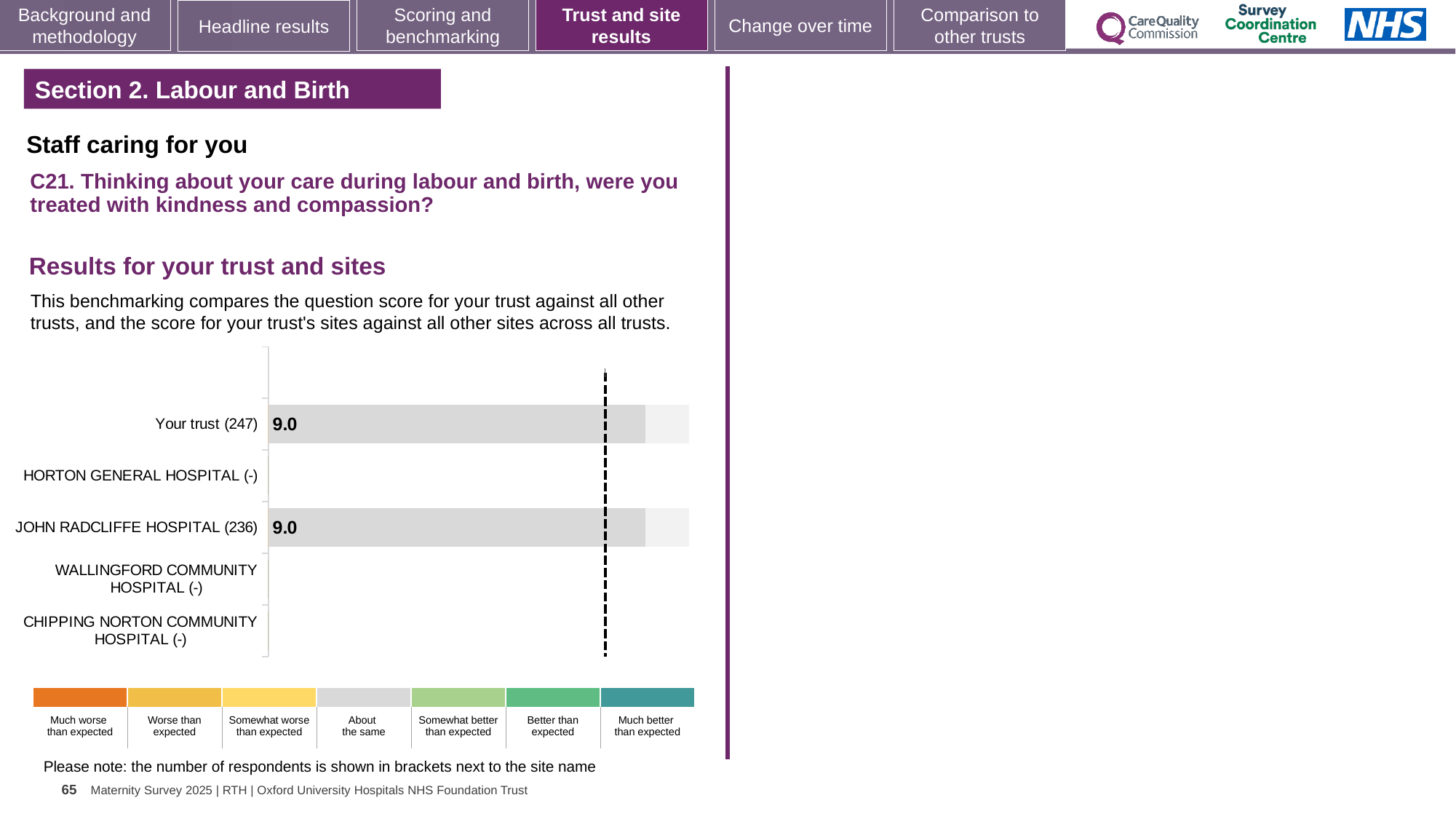
How many respondents are shown in brackets for Your trust? 247 What is the survey question shown above the chart? C21. Thinking about your care during labour and birth, were you treated with kindness and compassion? Is the score for Your trust higher than, lower than, or equal to the score for JOHN RADCLIFFE HOSPITAL? Equal What is the score for JOHN RADCLIFFE HOSPITAL? 9.0 What is the score for Your trust? 9.0 Which benchmark category does the grey colour of the plotted bars correspond to in the key? About the same What is the difference between the score for Your trust and the score for JOHN RADCLIFFE HOSPITAL? 0.0 How many respondents are shown in brackets for JOHN RADCLIFFE HOSPITAL? 236 What kind of chart is shown on the slide? Bar chart How many categories (trust and sites) are listed on the chart's axis? 5 How many sites on the chart have no score bar plotted? 3 How many benchmark categories does the colour key below the chart list? 7